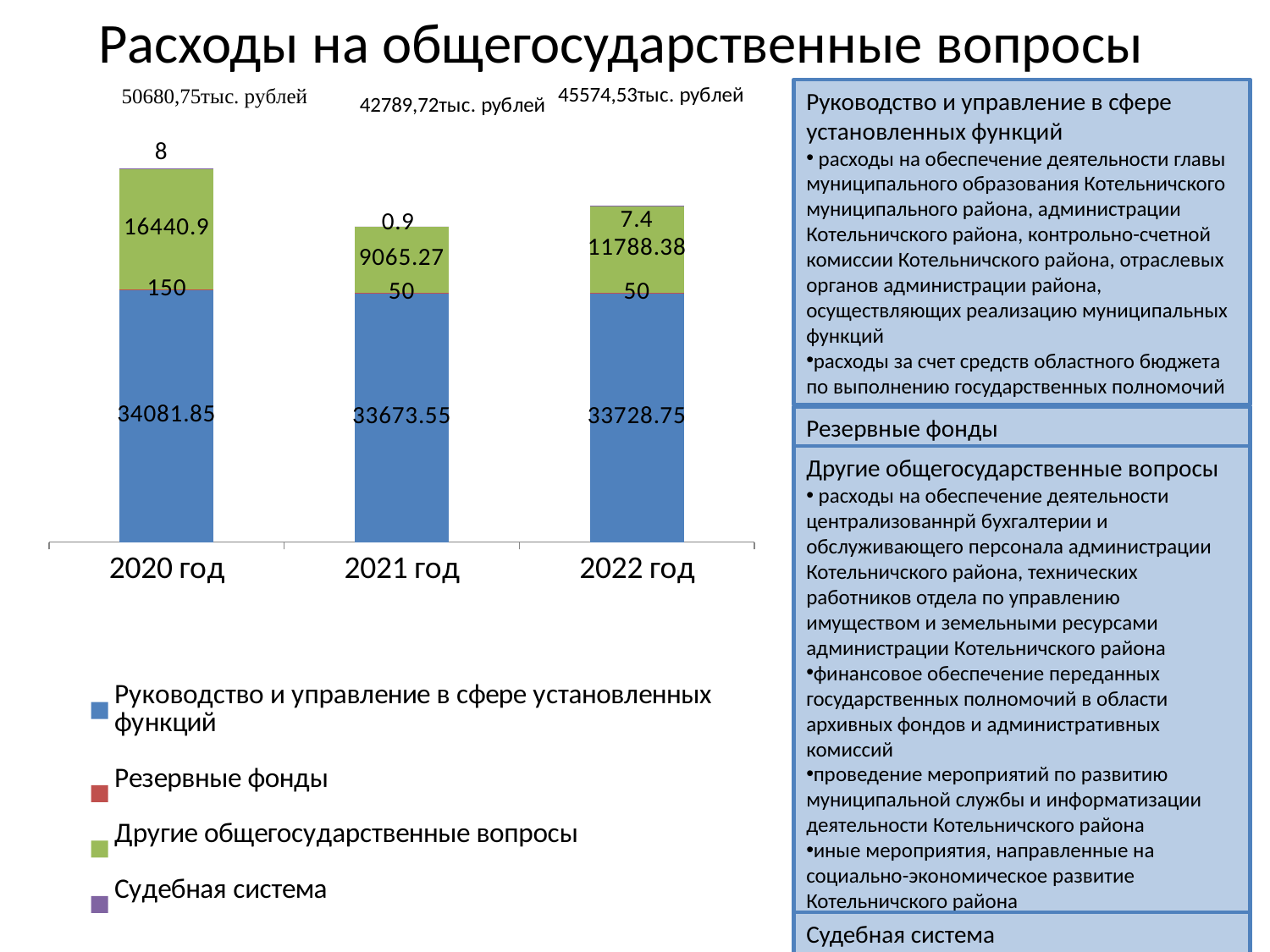
In which year is the value for Другие общегосударственные вопросы the highest? 2020 год What is the value for Резервные фонды in 2022 год? 50 How many series does the chart legend list? 4 What kind of chart is shown on the slide? stacked bar chart Which is larger: the value for Другие общегосударственные вопросы in 2022 год or in 2021 год? 2022 год What is the value for Другие общегосударственные вопросы in 2021 год? 9065.27 What is the value for Руководство и управление в сфере установленных функций in 2020 год? 34081.85 What is the difference between the Резервные фонды values for 2020 год and 2021 год? 100 In which year is the value for Руководство и управление в сфере установленных функций the lowest? 2021 год What total is printed above the bar for 2021 год? 42789,72тыс. рублей What is the value for Судебная система in 2022 год? 7.4 How many year categories are shown on the x axis of the chart? 3